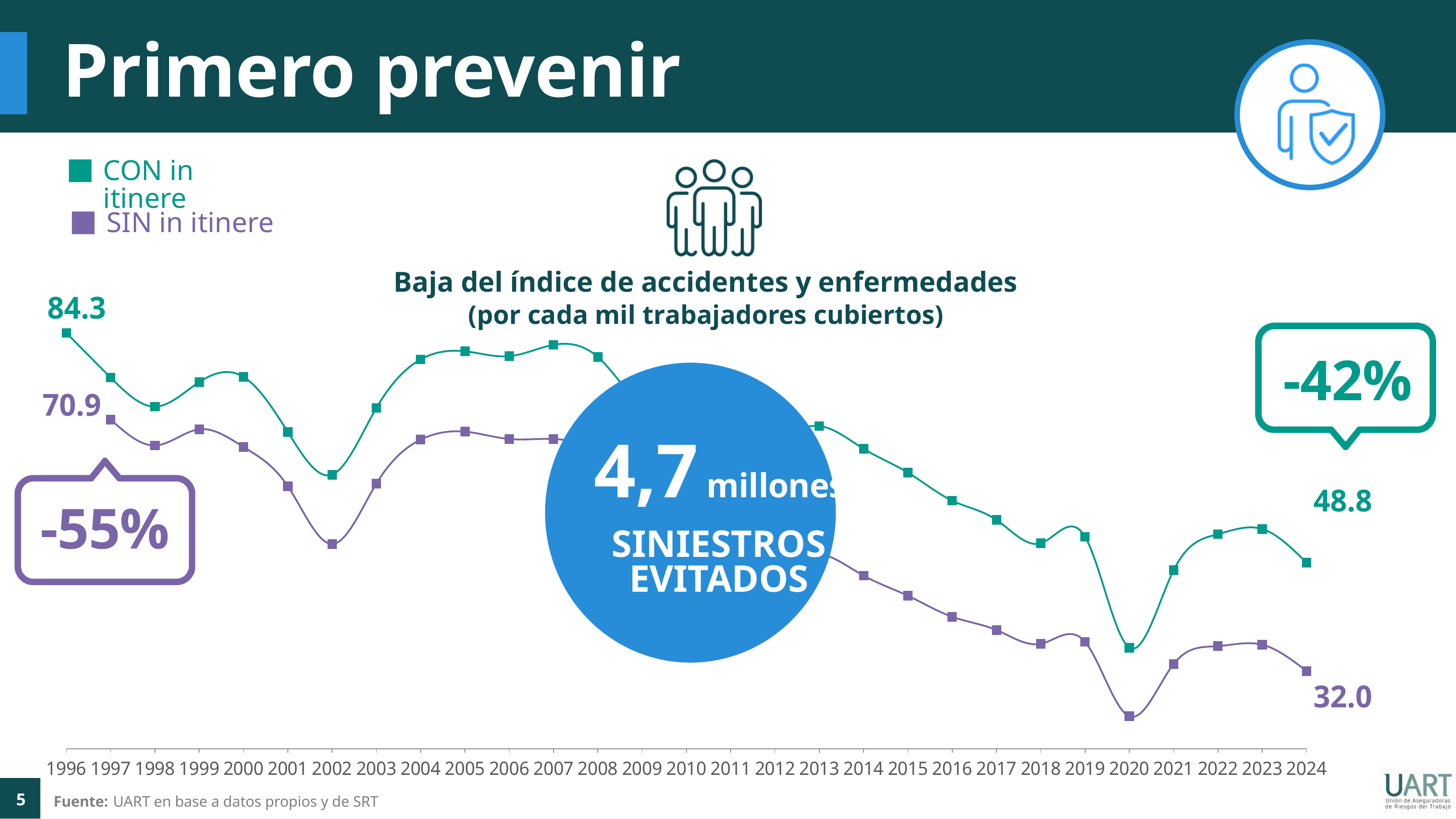
Do the values of the SIN in itinere series generally rise or fall from 1996 to 2024? fall What type of chart is shown on the slide? line chart What is the difference between the CON in itinere values for 1996 and 2024? 35.5 How many years are shown on the x axis? 29 What is the value for CON in itinere in 2024? 48.8 What is the value for SIN in itinere in 2024? 32.0 What is the value for CON in itinere in 1996? 84.3 In 2024, which series has the larger value, CON in itinere or SIN in itinere? CON in itinere In which year does the CON in itinere series reach its lowest point? 2020 How many series does the legend list? 2